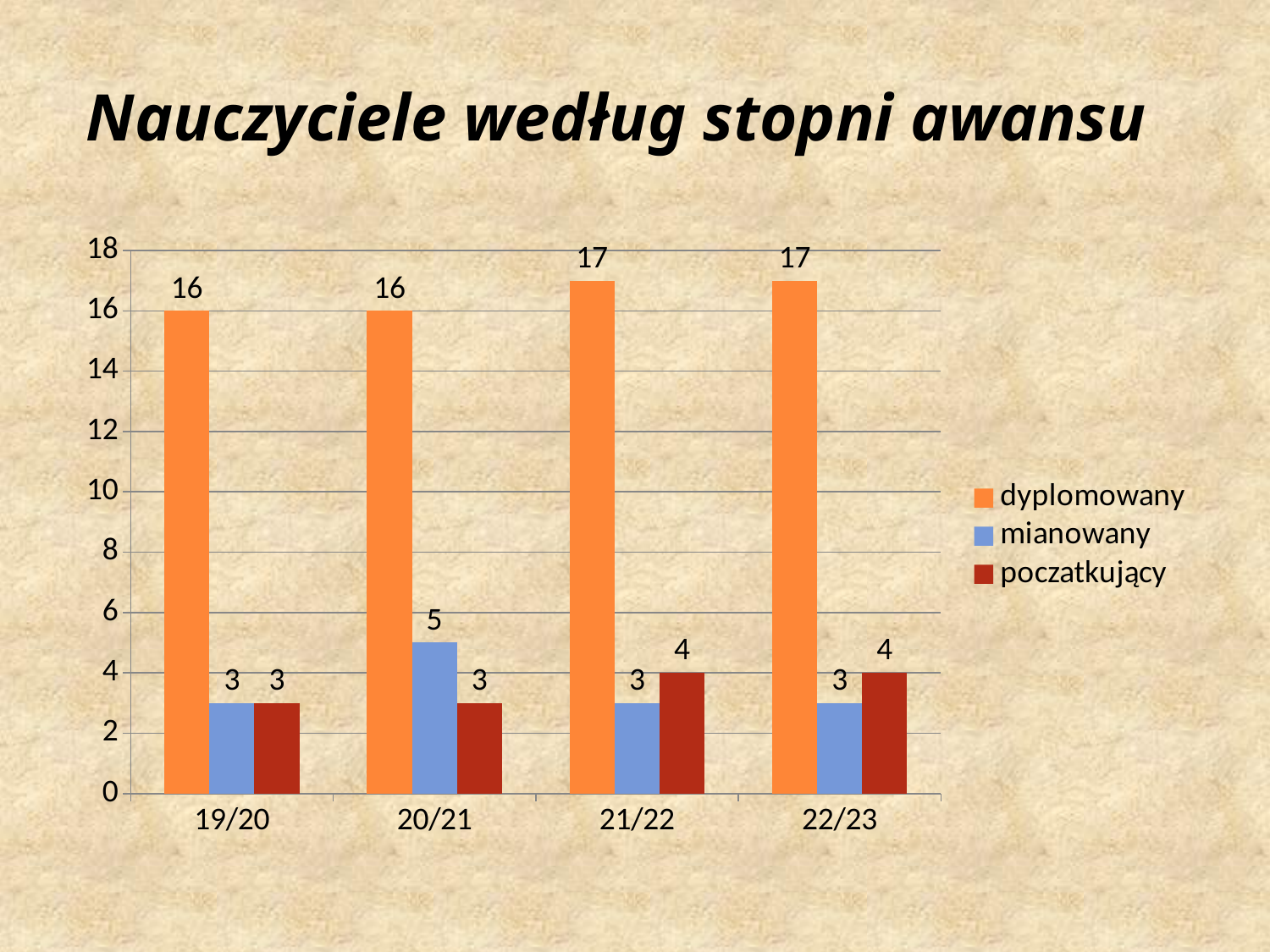
How many year categories are shown on the x axis? 4 How many series does the legend list? 3 What is the value for poczatkujący in 22/23? 4 What is the title of the slide? Nauczyciele według stopni awansu Does the dyplomowany series rise or fall from 19/20 to 22/23? rise Which series is shown in orange? dyplomowany Which is larger in 21/22, mianowany or poczatkujący? poczatkujący What is the value for dyplomowany in 21/22? 17 What is the value for mianowany in 20/21? 5 In which year is the mianowany value highest? 20/21 What kind of chart is shown on the slide? bar chart What is the difference between the dyplomowany values in 22/23 and 19/20? 1